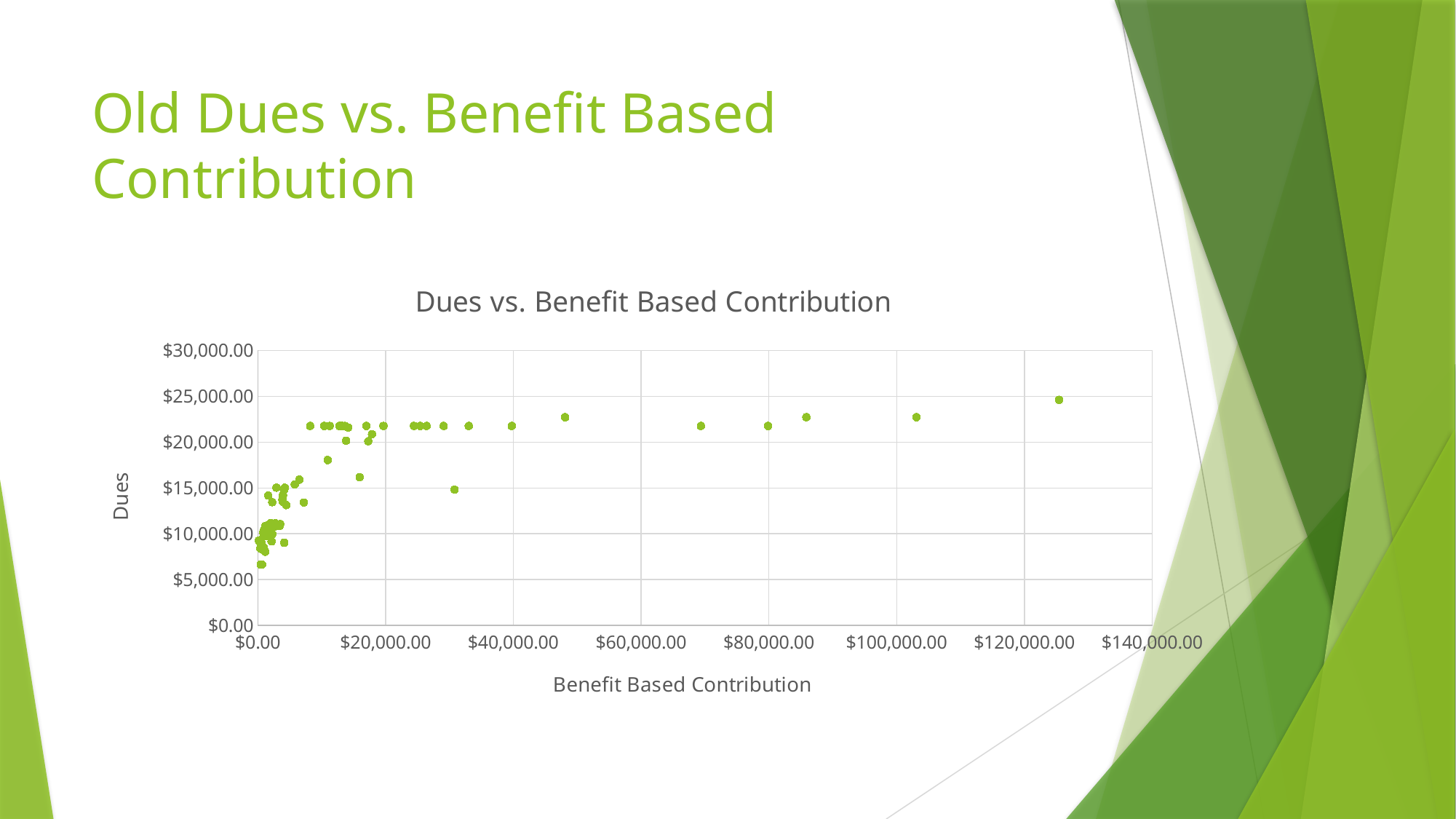
Is the Dues value for the point near $70,000.00 Benefit Based Contribution greater or less than $20,000.00? greater Is the Dues value for the point with the highest Benefit Based Contribution greater or less than $20,000.00? greater Is the Dues value for the point near $100,000.00 Benefit Based Contribution greater or less than $25,000.00? less What is the title of the chart? Dues vs. Benefit Based Contribution As Benefit Based Contribution increases along the x axis, do the Dues values generally rise or fall? Rise What is the label on the vertical axis of the chart? Dues What kind of chart is shown on the slide? Scatter chart